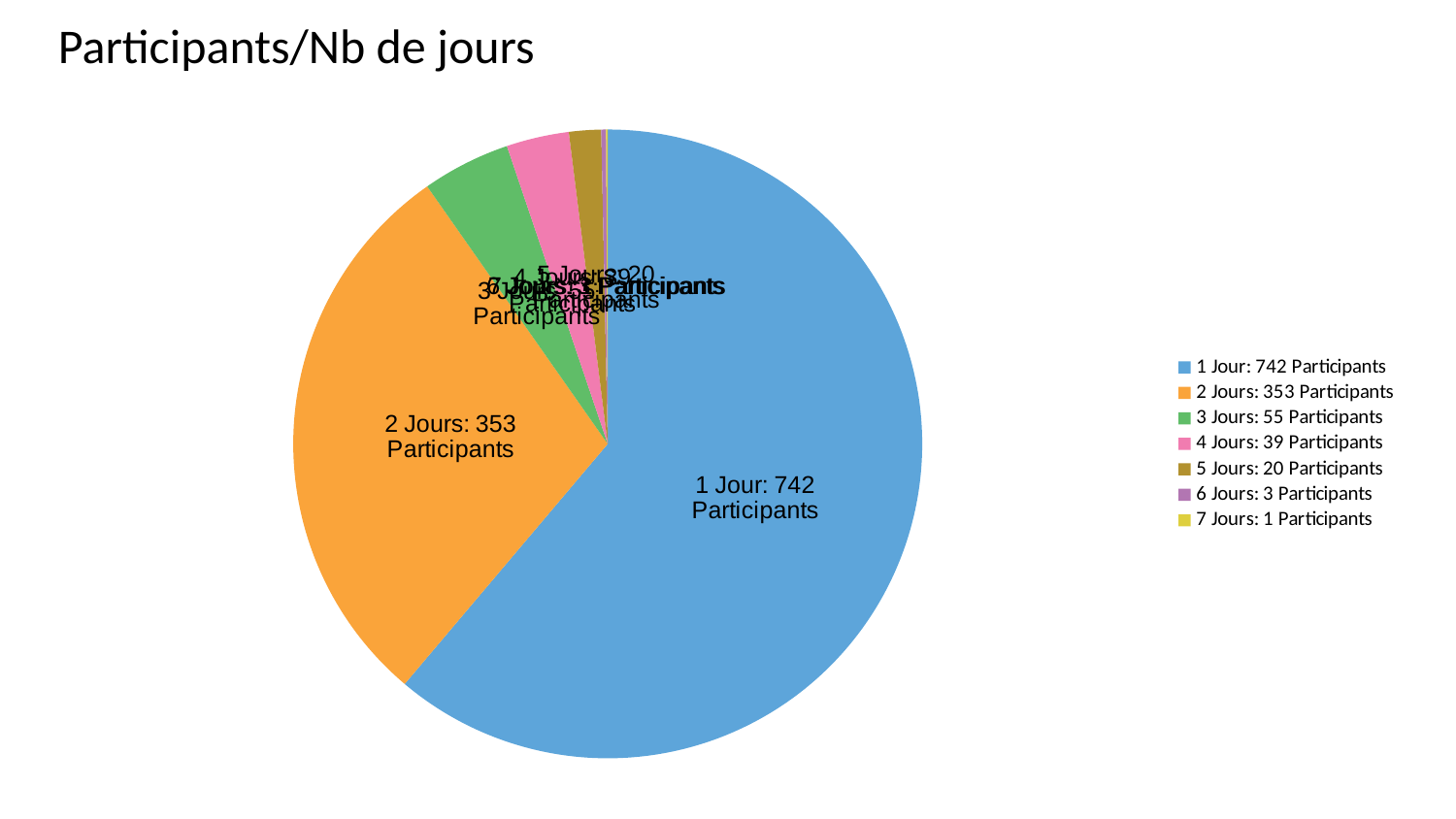
How many participants attended for 4 Jours? 39 How many participants attended for 2 Jours? 353 How many participants attended for 7 Jours? 1 What is the title of the chart? Participants/Nb de jours Which category has the smallest slice of the pie? 7 Jours What is the total number of participants across all categories? 1213 How many categories does the pie chart have? 7 How many participants attended for 1 Jour? 742 What is the difference in participants between 1 Jour and 2 Jours? 389 Which has more participants, 3 Jours or 5 Jours? 3 Jours Which category has the largest slice of the pie? 1 Jour What kind of chart is shown on the slide? Pie chart